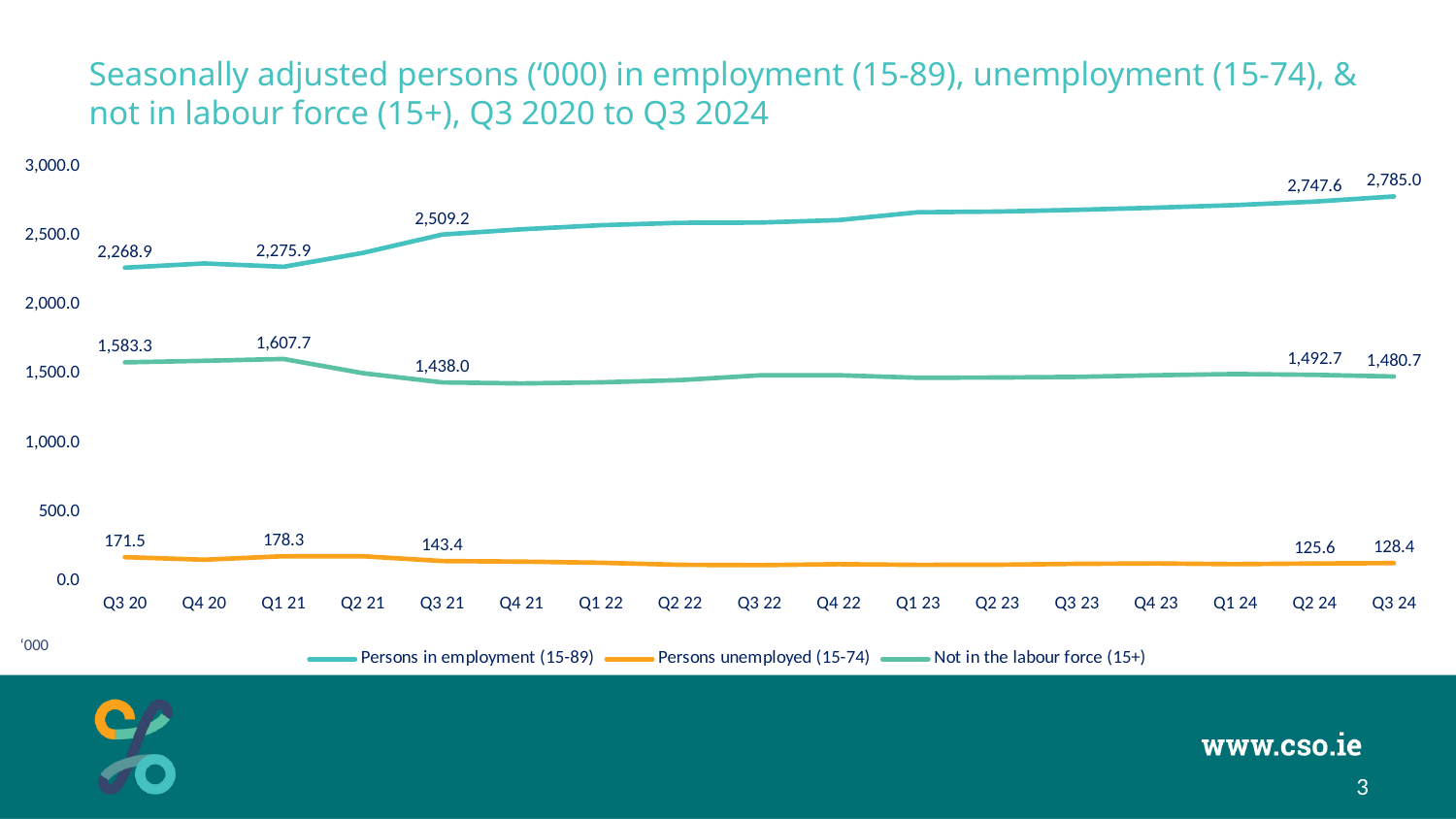
What is the difference between Persons unemployed (15-74) in Q1 21 and Q3 24? 49.9 Which is larger: Not in the labour force (15+) in Q1 21 or in Q3 21? Q1 21 What is the value for Persons unemployed (15-74) in Q3 21? 143.4 What is the value for Persons unemployed (15-74) in Q2 24? 125.6 Does the Persons in employment (15-89) series generally rise or fall from Q3 20 to Q3 24? Rise How many series does the legend list? 3 How many quarters are shown on the x axis? 17 What kind of chart is shown on the slide? Line chart What is the value for Not in the labour force (15+) in Q1 21? 1,607.7 What is the difference between Persons in employment (15-89) in Q3 24 and Q3 20? 516.1 What is the value for Persons in employment (15-89) in Q3 24? 2,785.0 Is the value for Persons in employment (15-89) in Q1 23 greater or less than 2,500.0? greater